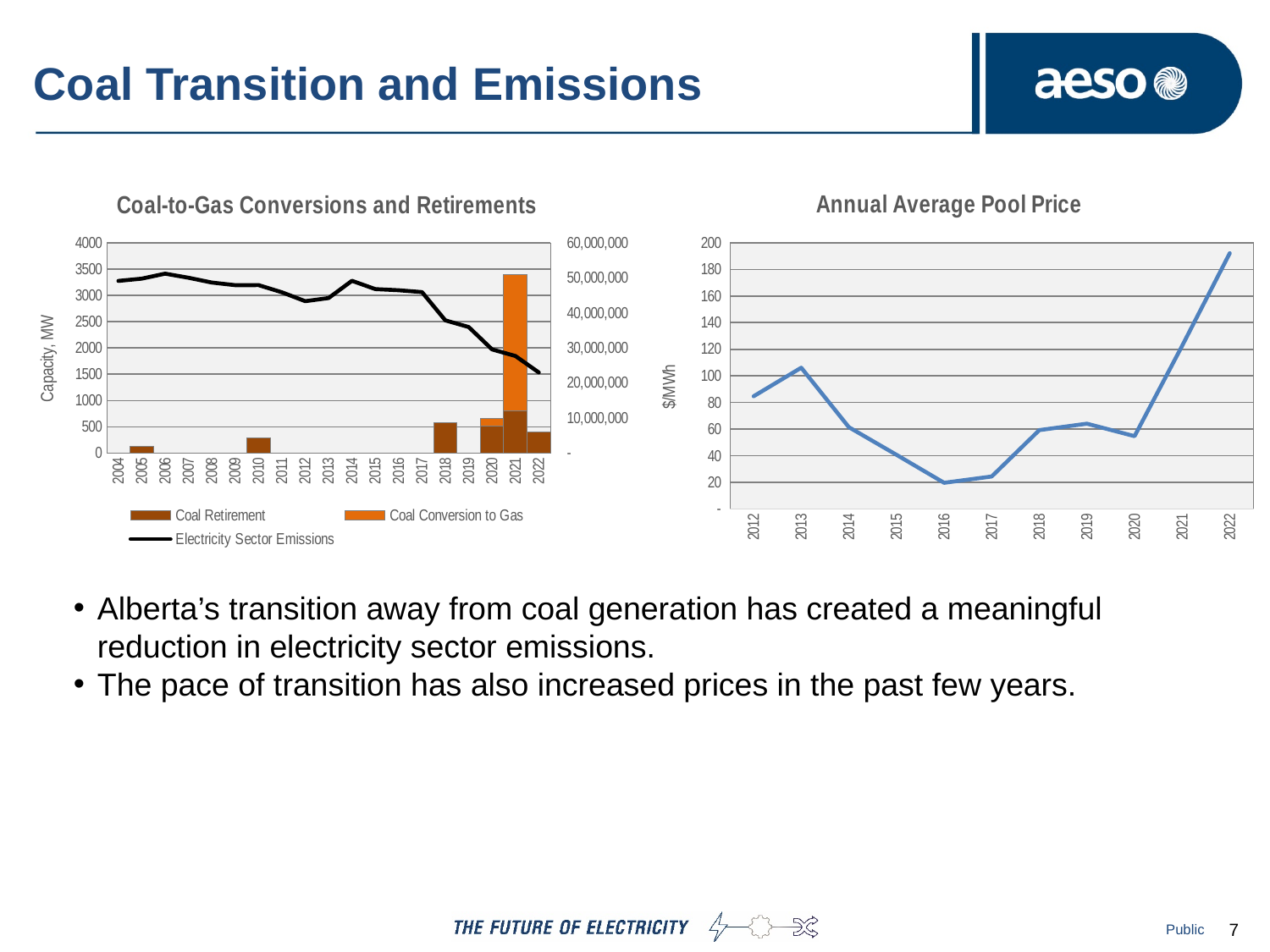
On the Annual Average Pool Price chart, which year has the highest value? 2022 On the Annual Average Pool Price chart, which is larger, the value for 2013 or the value for 2017? 2013 On the Coal-to-Gas Conversions and Retirements chart, how many series does the legend list? 3 On the Coal-to-Gas Conversions and Retirements chart, which year has the largest Coal Conversion to Gas bar? 2021 On the Coal-to-Gas Conversions and Retirements chart, does the Electricity Sector Emissions line rise or fall from 2014 to 2022? fall On the Annual Average Pool Price chart, which year has the lowest value? 2016 On the Coal-to-Gas Conversions and Retirements chart, is the Coal Conversion to Gas value for 2021 greater or less than 3000? less On the Annual Average Pool Price chart, how many years are shown on the x axis? 11 On the Annual Average Pool Price chart, is the value for 2014 greater or less than 80? less On the Annual Average Pool Price chart, is the value for 2016 greater or less than 40? less On the Annual Average Pool Price chart, does the value rise or fall from 2020 to 2022? rise